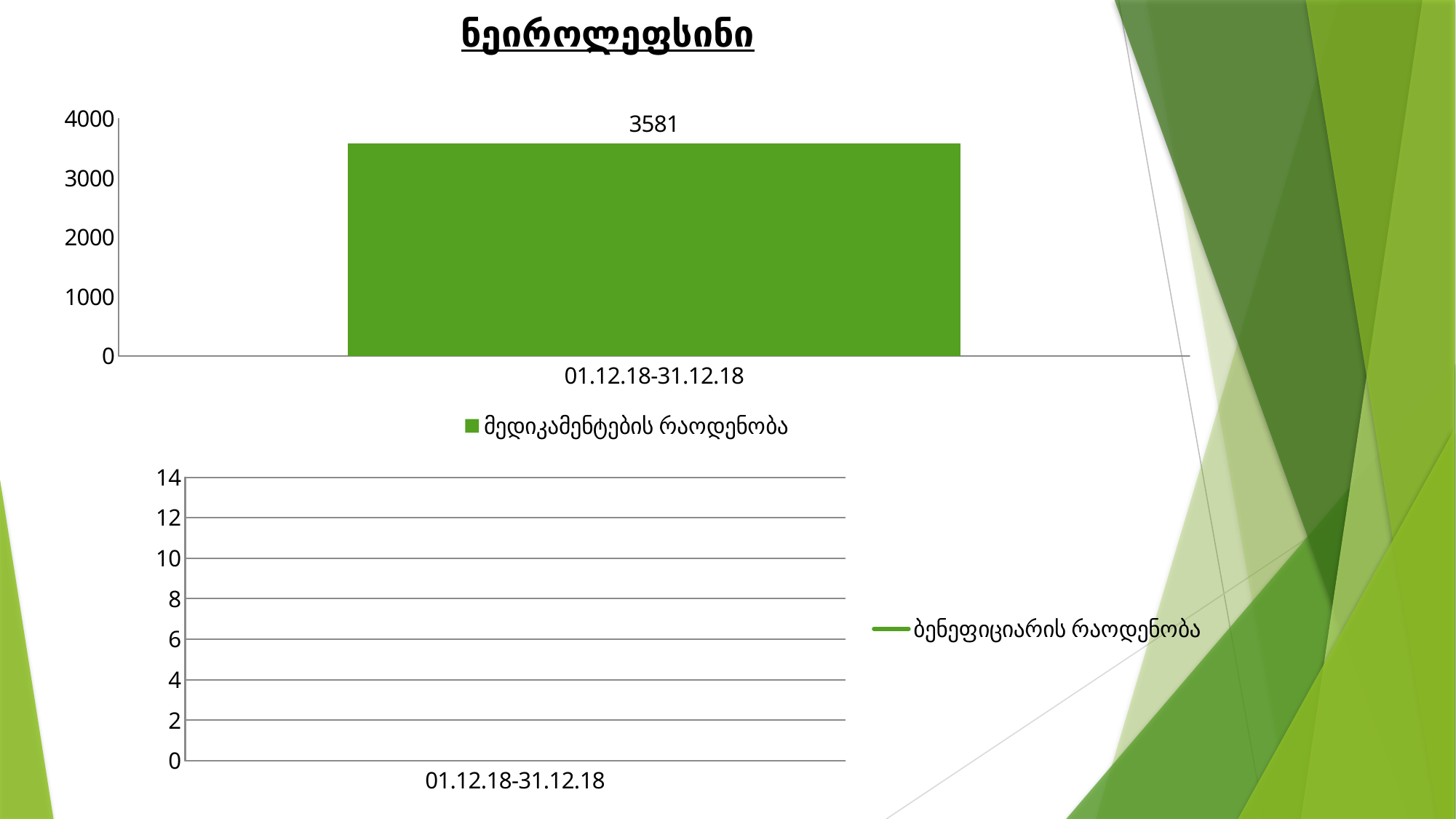
How many bars does the top chart show? 1 What is the legend entry of the top chart? მედიკამენტების რაოდენობა How many categories are shown on the x axis of the bottom chart? 1 How many series does the legend of the bottom chart list? 1 What kind of chart is the top chart? bar chart In the top chart, is the value for 01.12.18-31.12.18 greater or less than 4000? less In the top chart, is the value for 01.12.18-31.12.18 greater or less than 3000? greater What is the category label on the x axis of the top chart? 01.12.18-31.12.18 In the top chart, what is the value for 01.12.18-31.12.18? 3581 How many series does the legend of the top chart list? 1